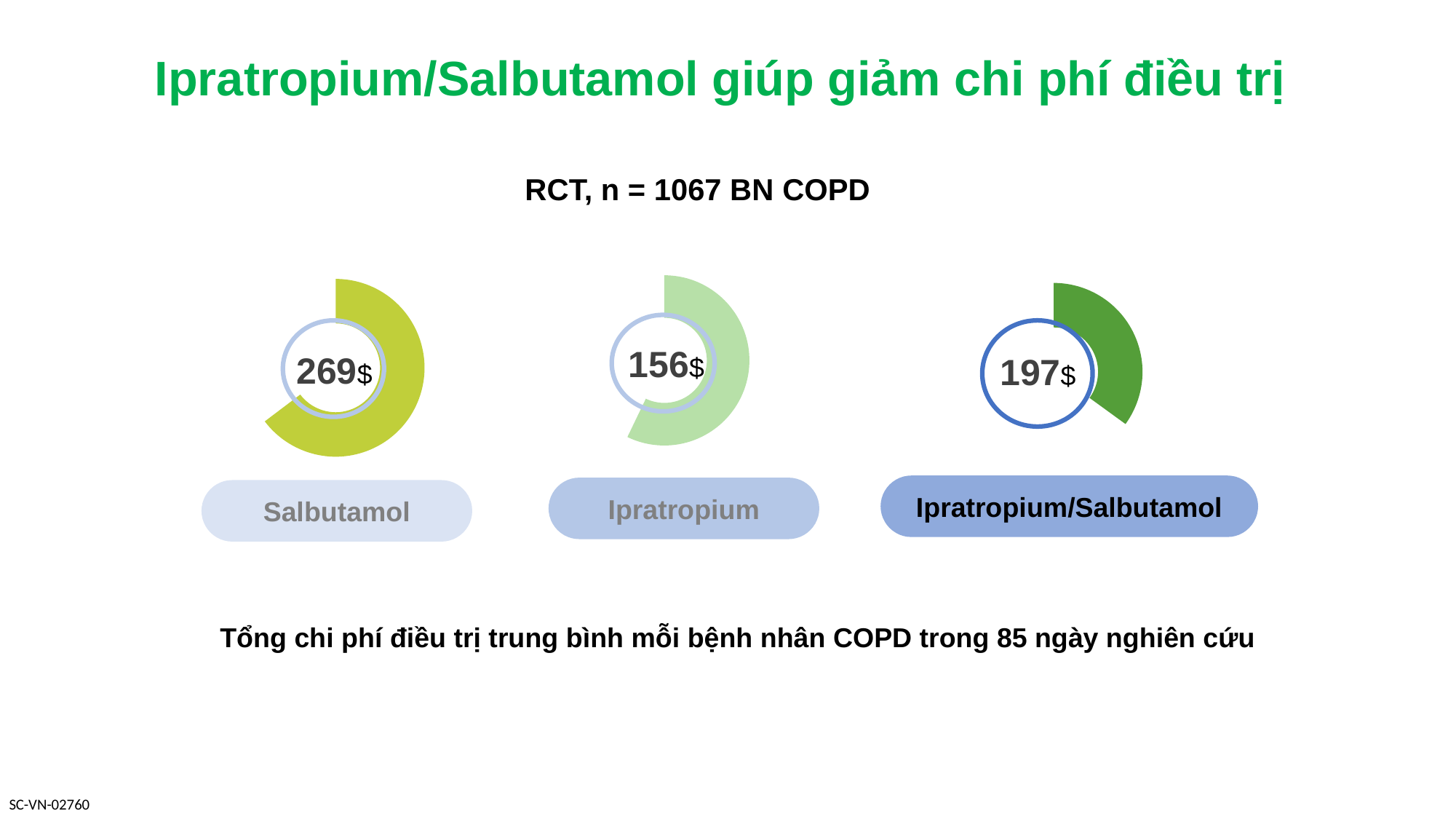
What is the difference in cost between Ipratropium/Salbutamol and Ipratropium? 41$ Which treatment has the highest average cost on the slide? Salbutamol What is the difference in cost between Salbutamol and Ipratropium/Salbutamol? 72$ How many treatment groups are shown on the slide? 3 Which has a higher cost, Ipratropium or Ipratropium/Salbutamol? Ipratropium/Salbutamol What kind of chart is used to display each treatment cost? Donut chart What is the average treatment cost shown for Ipratropium/Salbutamol? 197$ Which treatment has the lowest average cost on the slide? Ipratropium What is the difference in cost between Salbutamol and Ipratropium? 113$ What is the sample size (n) of the RCT stated on the slide? 1067 What is the average treatment cost shown for Ipratropium? 156$ What is the average treatment cost shown for Salbutamol? 269$